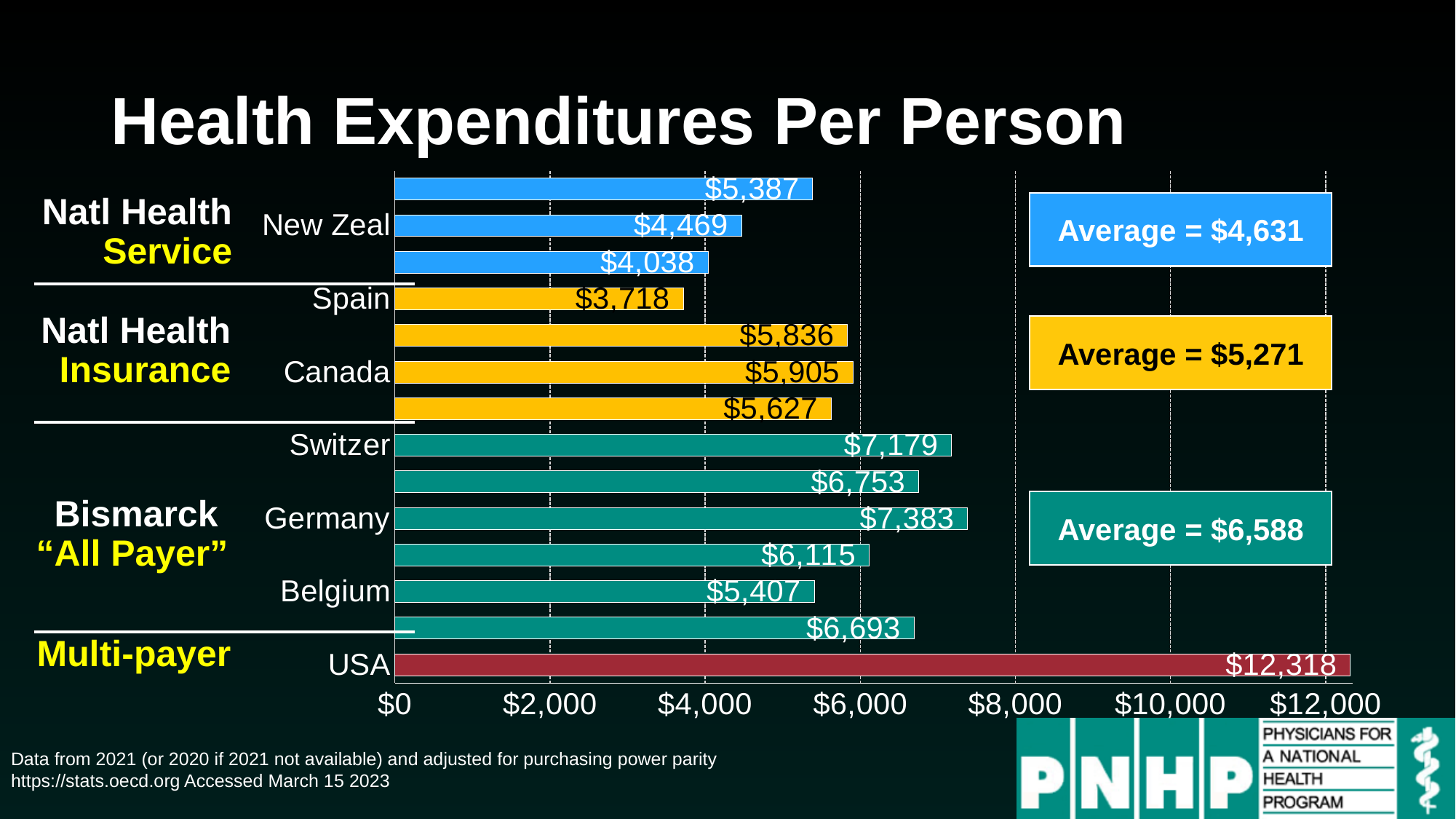
What is the value shown for Canada? $5,905 What is the average shown for the Bismarck "All Payer" group? $6,588 How many bars are plotted in the chart? 14 What is the value shown for Germany? $7,383 What is the value shown for Spain? $3,718 What is the health expenditure per person for the USA? $12,318 Is the value for Belgium greater or less than $6,000? less Which is larger, the value for Switzer or the value for Canada? Switzer Which labeled country has the lowest health expenditure per person? Spain What is the difference between the USA value and the Germany value? $4,935 Which country has the highest health expenditure per person? USA What kind of chart is shown on the slide? Bar chart